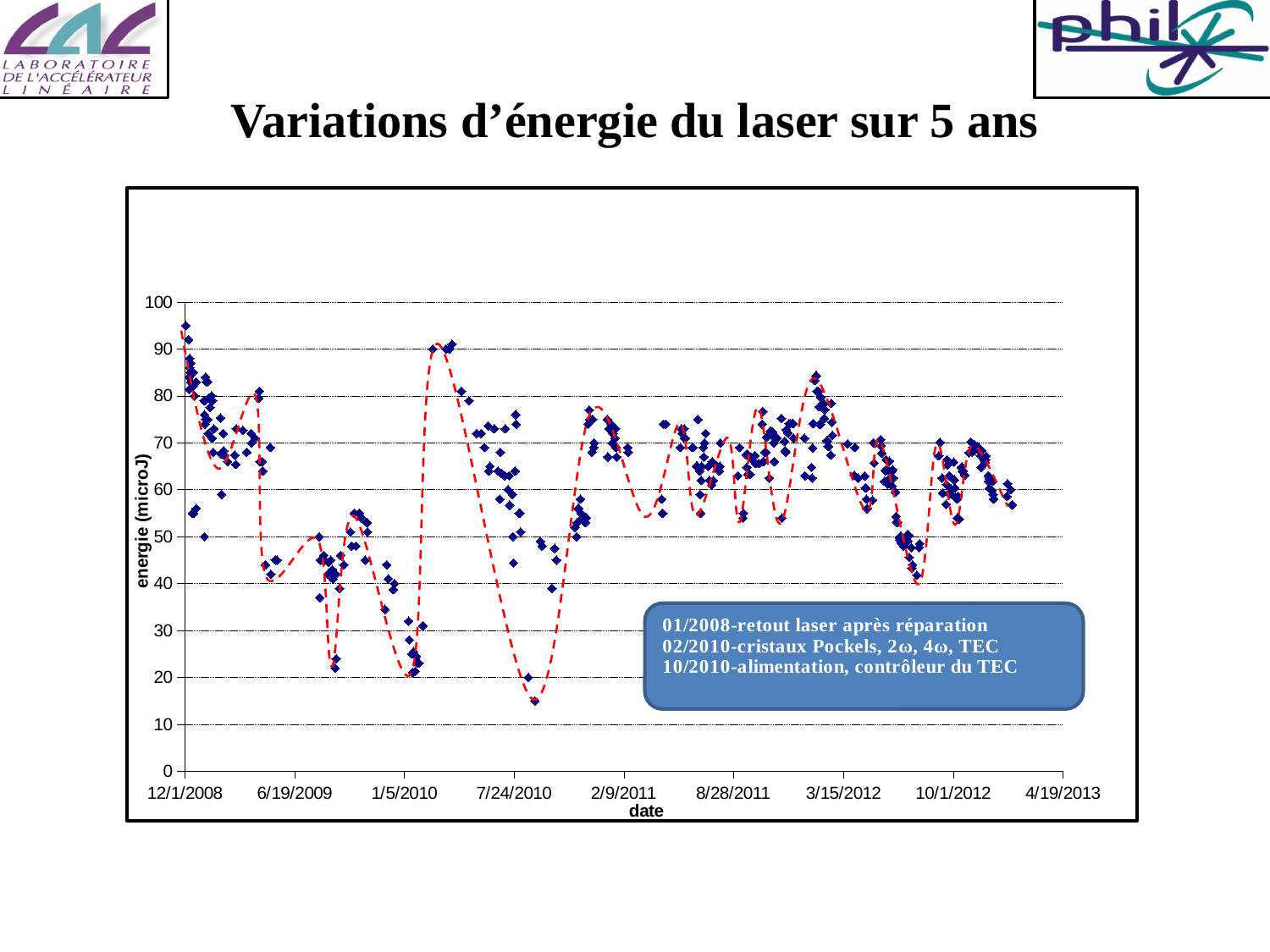
What kind of chart is shown on the slide? scatter chart Is the lowest plotted energy value greater or less than 20? less What is the label of the horizontal axis of the chart? date Around the 3/15/2012 tick, are the plotted energy values greater or less than 50? greater Is the highest plotted energy value greater or less than 90? greater What is the last date label on the horizontal axis? 4/19/2013 Between 12/1/2008 and 6/19/2009, do the plotted energy values generally rise or fall? fall What is the label of the vertical axis of the chart? energie (microJ) What is the highest value shown on the vertical axis? 100 What is the first date label on the horizontal axis? 12/1/2008 How many date labels are shown on the horizontal axis? 9